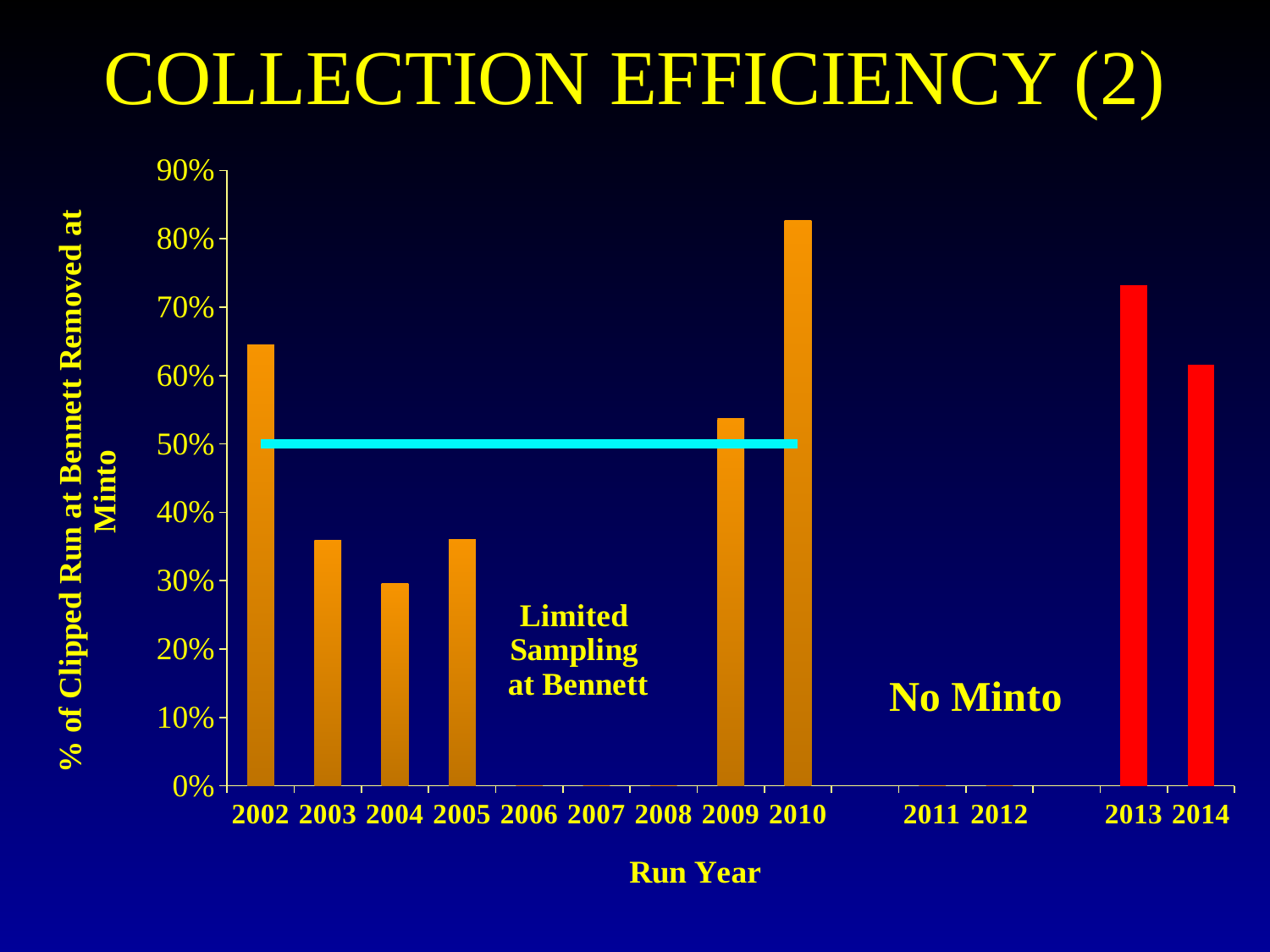
How many run years are labelled on the x axis? 13 Which run year has the highest percentage of clipped run removed at Minto? 2010 What kind of chart is shown on the slide? bar chart Is the value for 2002 greater or less than 60%? greater Is the value for 2010 greater or less than 80%? greater Which has the larger value, 2002 or 2009? 2002 Among the years with a bar plotted, which run year has the lowest percentage? 2004 What is the title of the x axis? Run Year Is the value for 2013 greater or less than 70%? greater Which has the larger value, 2013 or 2014? 2013